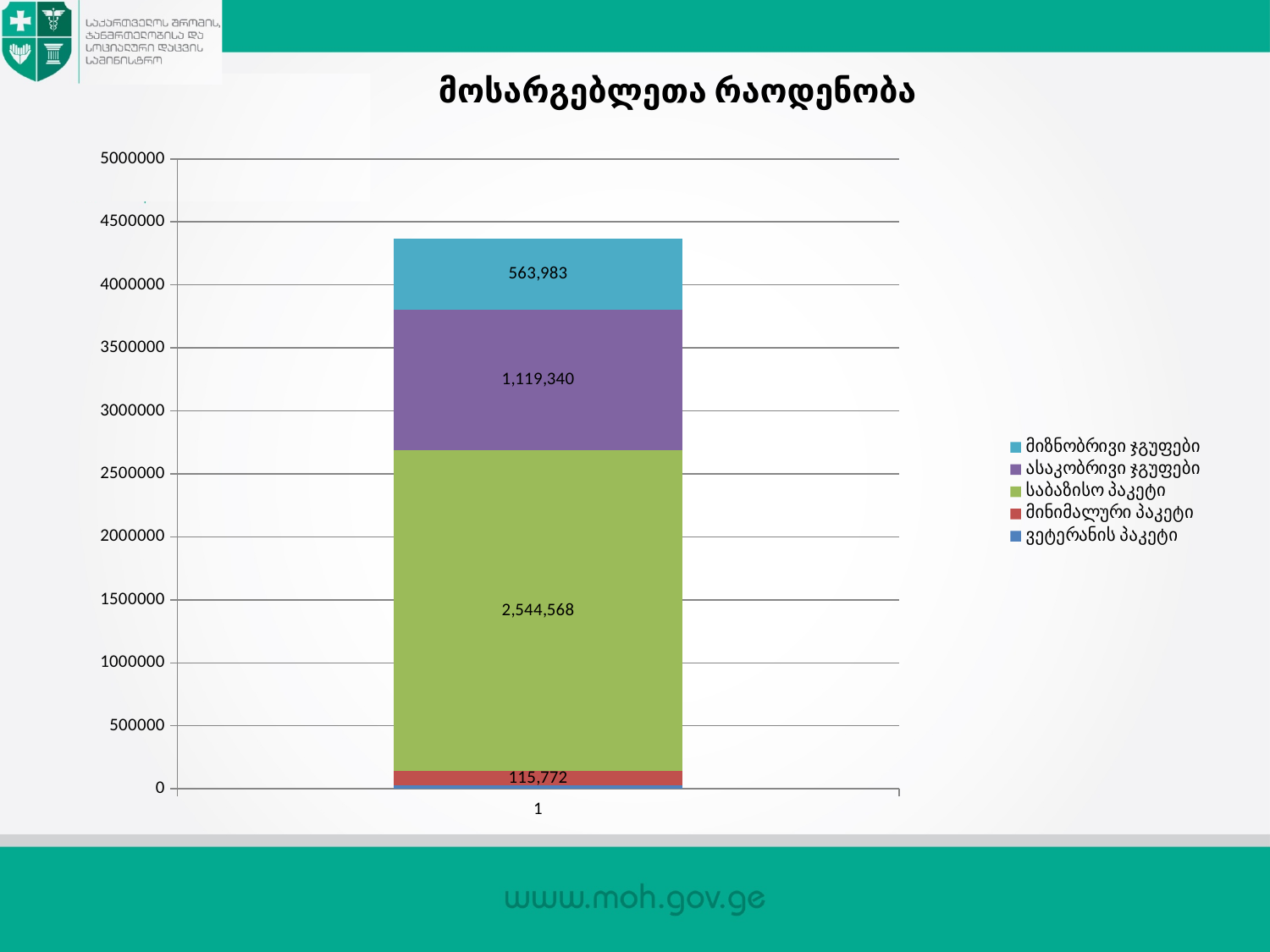
What is the title of the chart? მოსარგებლეთა რაოდენობა Which series has the smallest segment in the stacked bar? ვეტერანის პაკეტი What type of chart is shown on the slide? Stacked bar chart What is the value for საბაზისო პაკეტი? 2,544,568 What is the difference between the values for საბაზისო პაკეტი and ასაკობრივი ჯგუფები? 1,425,228 Which is larger, the value for ასაკობრივი ჯგუფები or the value for მიზნობრივი ჯგუფები? ასაკობრივი ჯგუფები What is the value for მინიმალური პაკეტი? 115,772 What is the value for ასაკობრივი ჯგუფები? 1,119,340 Is the total height of the stacked bar greater or less than 4000000? greater Which series has the largest segment in the stacked bar? საბაზისო პაკეტი How many series does the legend list? 5 What is the value for მიზნობრივი ჯგუფები? 563,983